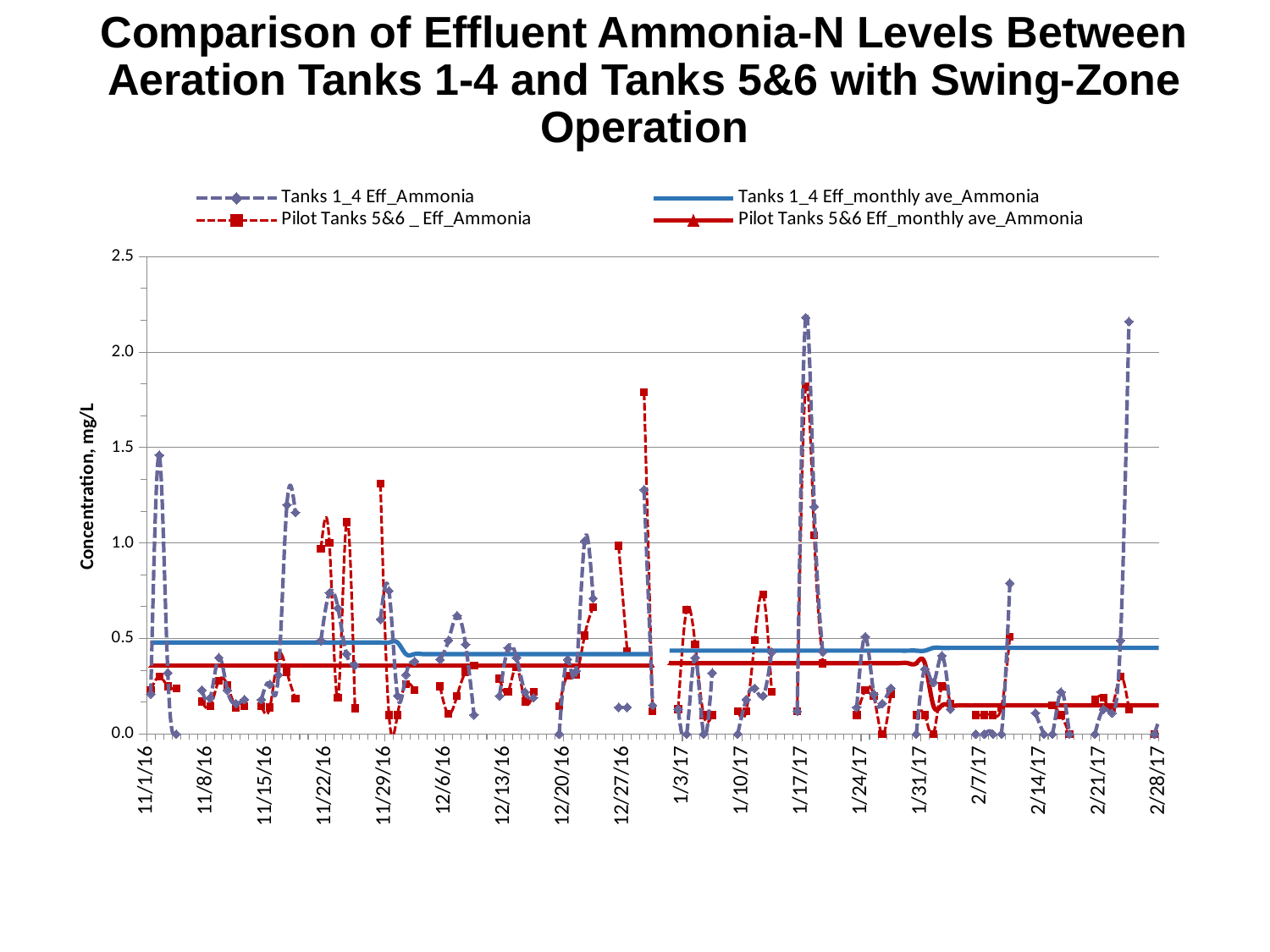
Is the peak value of Tanks 1_4 Eff_Ammonia near 1/17/17 greater or less than 2.0? greater What is the first date shown on the horizontal axis? 11/1/16 Around 1/17/17, which series has the higher peak: Tanks 1_4 Eff_Ammonia or Pilot Tanks 5&6 _ Eff_Ammonia? Tanks 1_4 Eff_Ammonia In February 2017, which monthly average line is higher: Tanks 1_4 Eff_monthly ave_Ammonia or Pilot Tanks 5&6 Eff_monthly ave_Ammonia? Tanks 1_4 Eff_monthly ave_Ammonia What is the label on the vertical axis of the chart? Concentration, mg/L How many series does the legend list? 4 Is the Tanks 1_4 Eff_monthly ave_Ammonia value in November 2016 greater or less than 1.0? less What kind of chart is shown on the slide? Line chart Is the Pilot Tanks 5&6 Eff_monthly ave_Ammonia value in February 2017 greater or less than 0.5? less Does the Pilot Tanks 5&6 Eff_monthly ave_Ammonia line rise or fall from January 2017 to February 2017? fall Which series reaches the highest peak value on the chart? Tanks 1_4 Eff_Ammonia